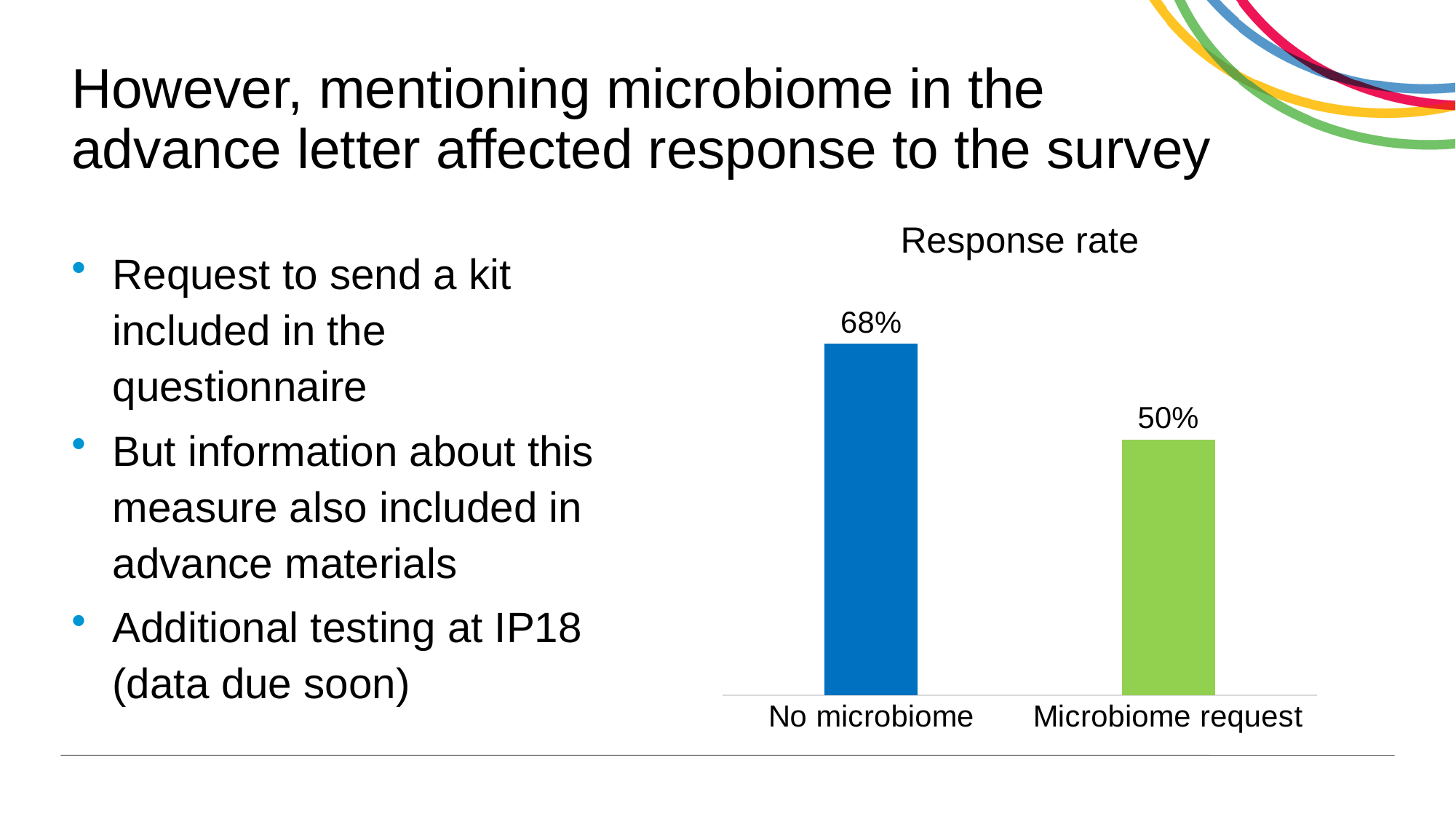
What is the response rate for the Microbiome request group? 50% What kind of chart is shown on the slide? Bar chart Which category has the highest response rate? No microbiome What colour is the bar for Microbiome request? Green Do the response rates rise or fall from left to right across the categories? Fall What is the difference in response rate between No microbiome and Microbiome request? 18% What is the title of the chart? Response rate Which category has the lowest response rate? Microbiome request What is the response rate for the No microbiome group? 68% How many categories are shown in the chart? 2 Which has a larger response rate, No microbiome or Microbiome request? No microbiome